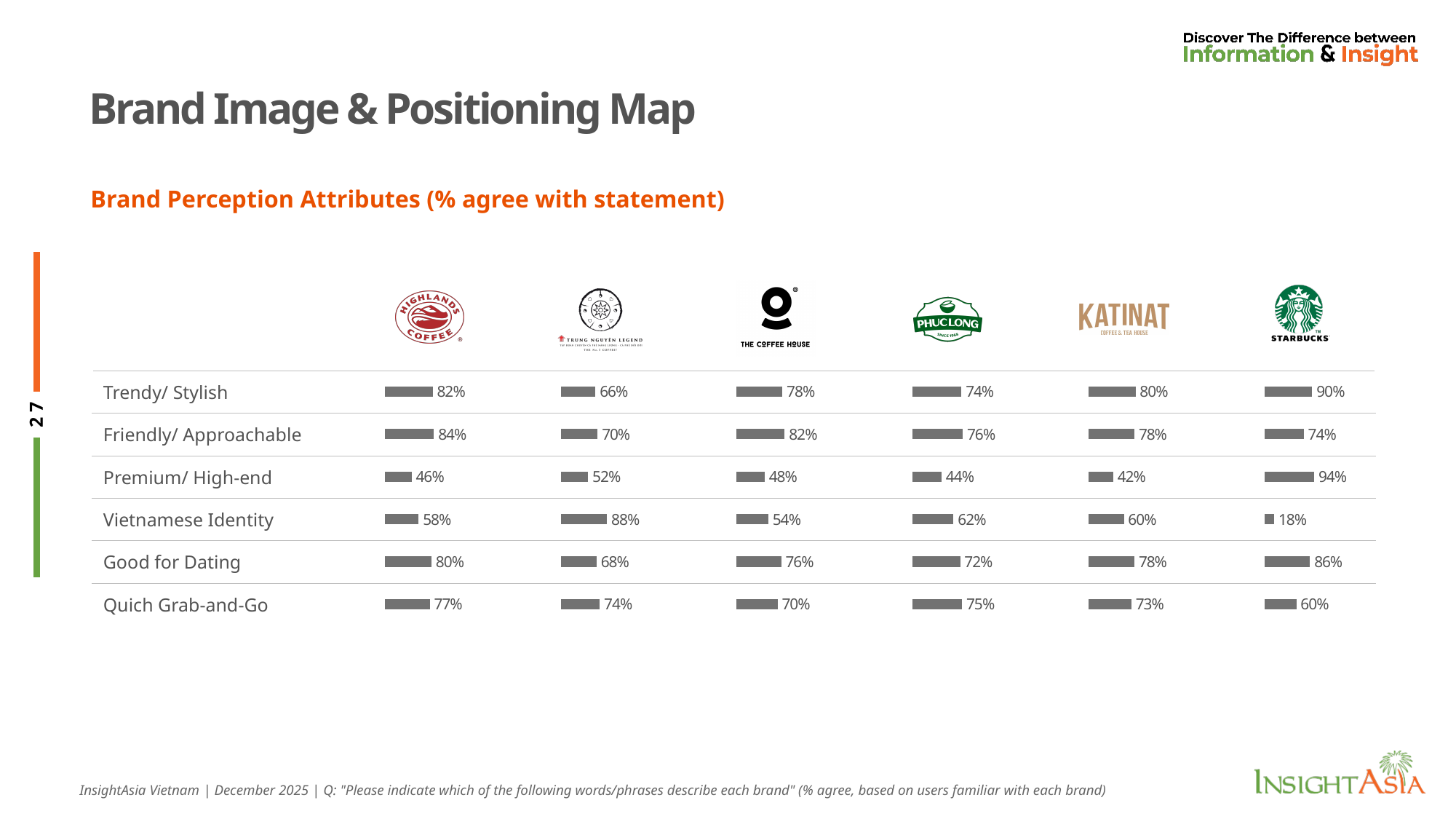
What percentage of respondents agree that Starbucks is Premium/ High-end? 94% What is the Vietnamese Identity value for Trung Nguyên Legend? 88% Which brand has the lowest Vietnamese Identity score? Starbucks Which brand has the highest Friendly/ Approachable score? Highlands Coffee How many brands are compared in the table? 6 How many brand perception attributes are listed? 6 Which brand has the highest Trendy/ Stylish score? Starbucks What is the difference between Starbucks and Katinat on Premium/ High-end? 52% What is the subtitle of the chart on the slide? Brand Perception Attributes (% agree with statement) What is the Good for Dating value for Katinat? 78% What kind of chart is used to show the values in the table? Bar chart Which is higher for Quich Grab-and-Go: Highlands Coffee or The Coffee House? Highlands Coffee